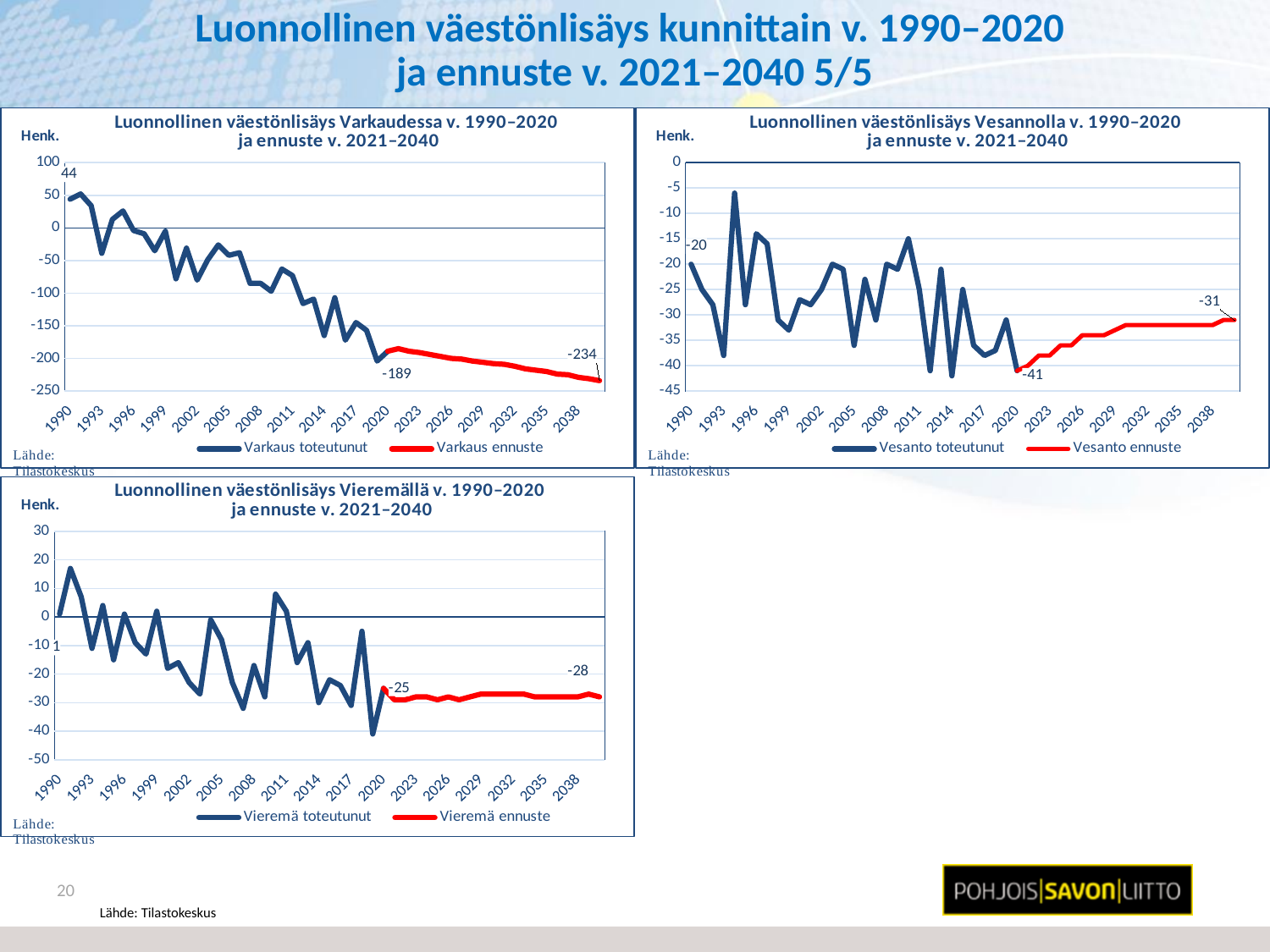
In the Varkaus chart, what is the labelled value for 1990? 44 In the Vesanto chart, what is the labelled value for 2020? -41 In the Varkaus chart, what is the labelled value for 2020? -189 What kind of chart is the Varkaus chart? line chart In the Vieremä chart, is the 2020 value (-25) larger or smaller than the 2040 forecast value (-28)? larger In the Vesanto chart, what is the labelled value for 1990? -20 In the Varkaus chart, what is the difference between the 1990 value (44) and the 2020 value (-189)? 233 In the Varkaus chart, what is the forecast value labelled at the end of the series in 2040? -234 In the Vieremä chart, what is the labelled value for 2020? -25 In the Vieremä chart, what is the forecast value labelled for 2040? -28 In the Vesanto chart, what is the forecast value labelled for 2040? -31 How many series does the legend of the Vesanto chart list? 2